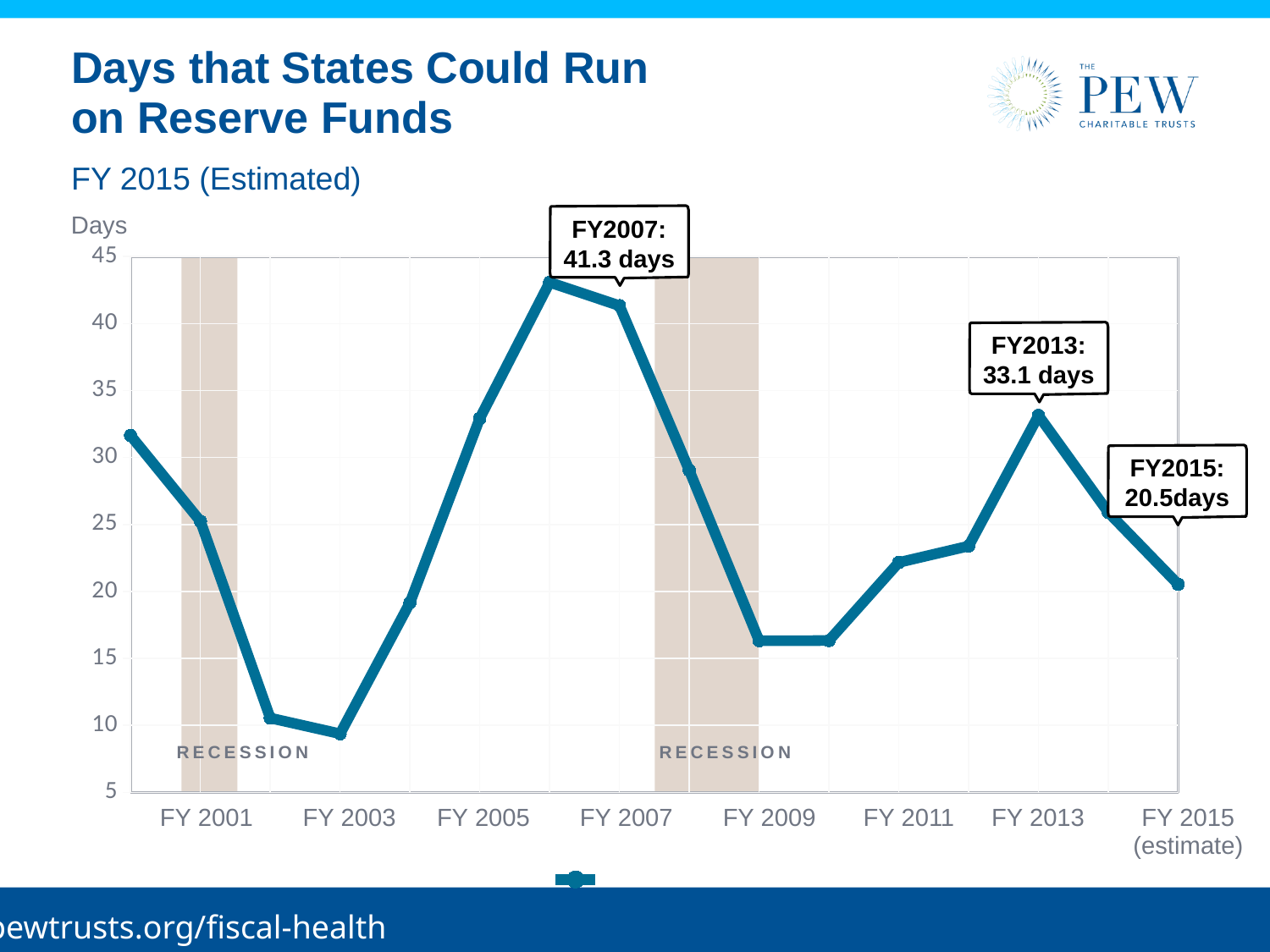
Do the values rise or fall from FY 2013 to FY 2015? fall How many days could states run on reserve funds in FY2007, according to the data label? 41.3 days Which is larger, the value for FY 2005 or the value for FY 2009? FY 2005 Is the value for FY 2003 greater or less than 10? less What label appears in the two shaded vertical bands on the chart? RECESSION What is the estimated value labeled for FY2015? 20.5days What is the difference between the labeled FY2013 value and the labeled FY2015 value? 12.6 days Is the value for FY 2009 greater or less than 20? less What value is labeled for FY2013? 33.1 days What is the difference between the labeled FY2007 value and the labeled FY2013 value? 8.2 days What kind of chart is shown on the slide? line chart Which is larger, the value for FY 2007 or the value for FY 2013? FY 2007